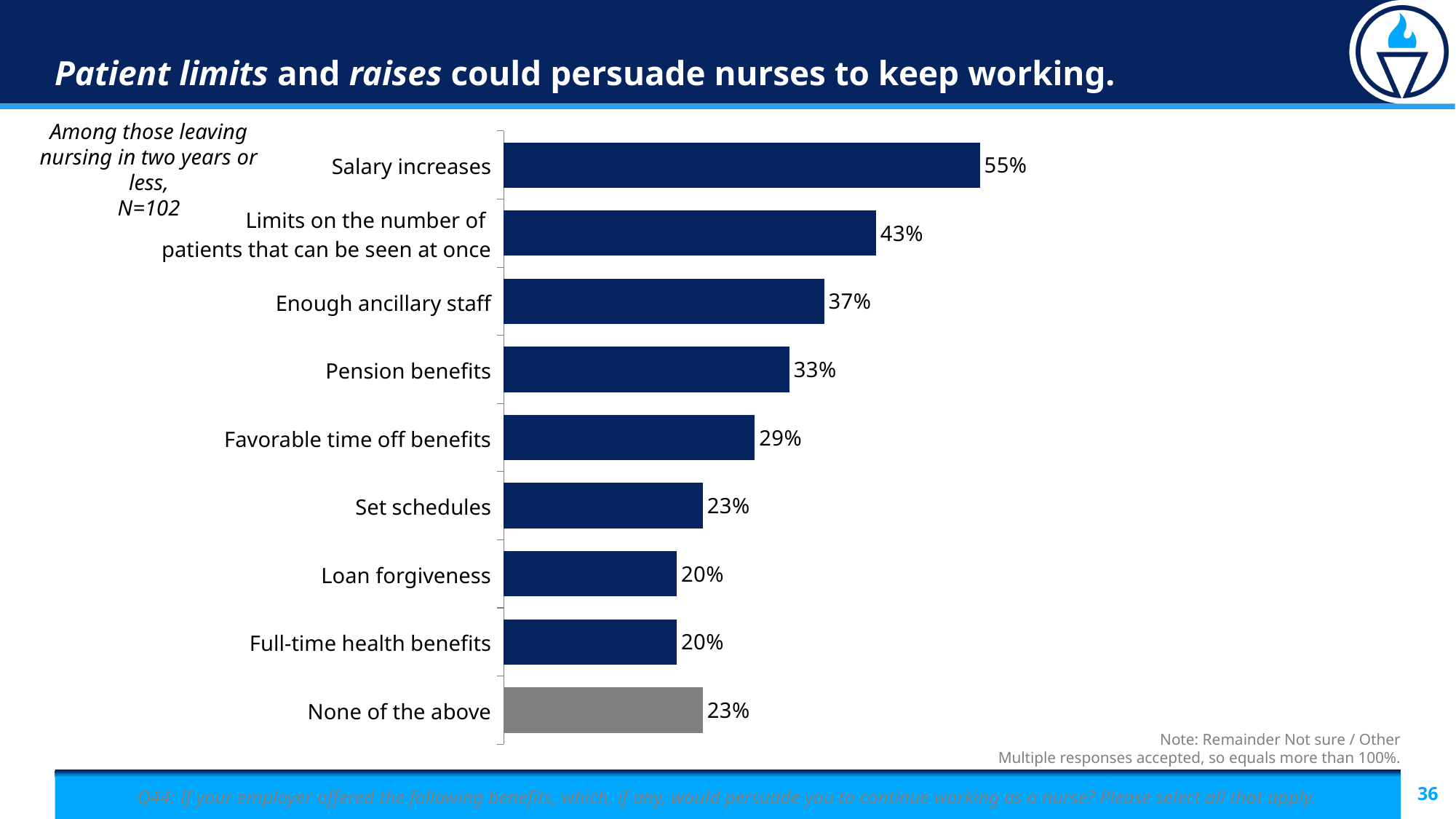
Which bar on the chart is coloured grey rather than dark blue? None of the above What is the value for 'Favorable time off benefits'? 29% What percentage of respondents said salary increases would persuade them to continue working as a nurse? 55% What is the sample size (N) noted for the chart? N=102 What is the difference between the values for 'Limits on the number of patients that can be seen at once' and 'Full-time health benefits'? 23% What kind of chart is shown on the slide? Bar chart Which is larger, the value for 'Set schedules' or the value for 'Loan forgiveness'? Set schedules Which category has the highest value on the chart? Salary increases What percentage is shown for 'Enough ancillary staff'? 37% What is the difference between the values for 'Salary increases' and 'Pension benefits'? 22% How many categories are shown on the chart? 9 What is the value for 'Limits on the number of patients that can be seen at once'? 43%